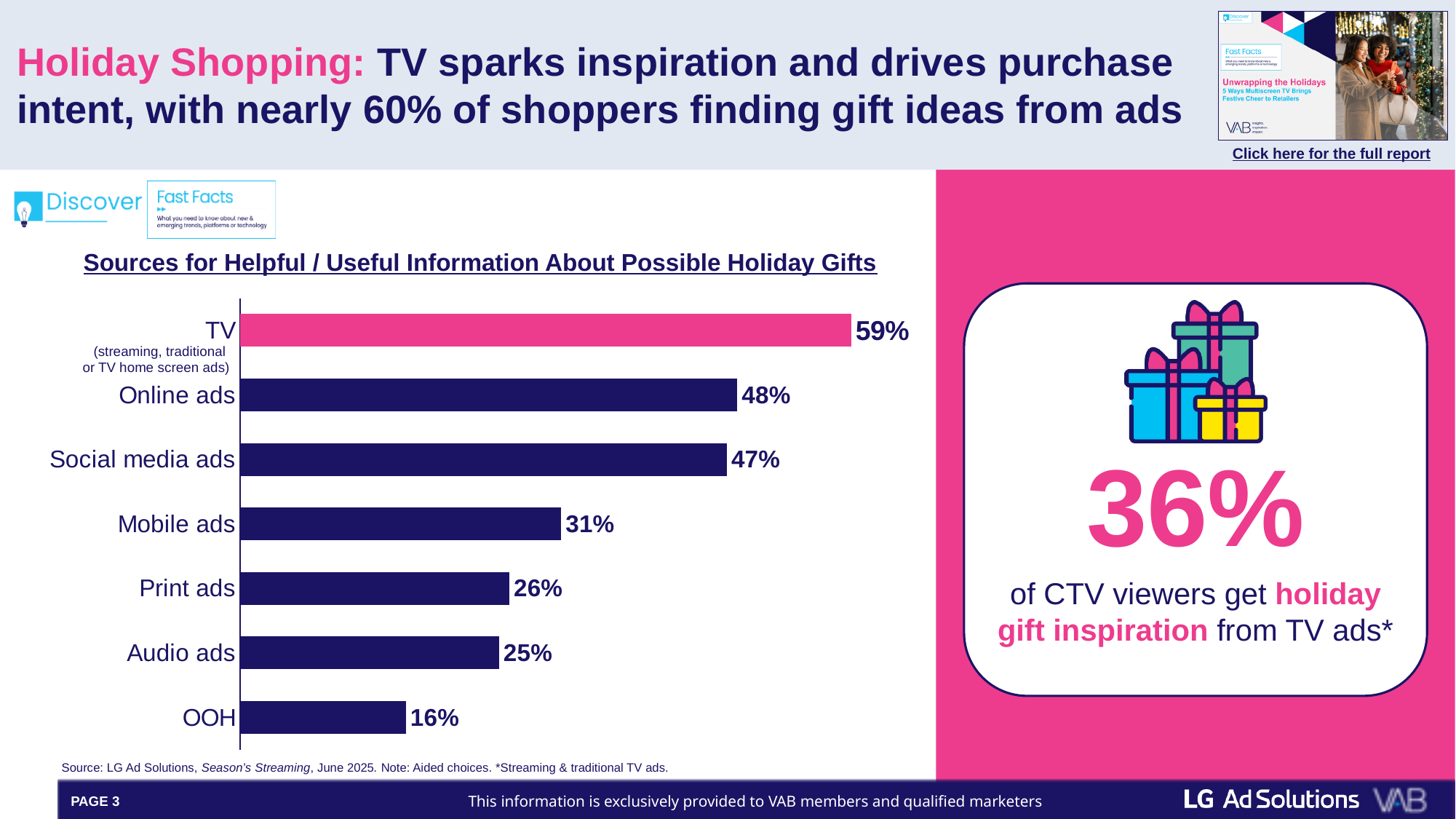
Which source has the lowest percentage in the chart? OOH What type of chart is used to show the sources for helpful information about holiday gifts? Bar chart What is the difference in percentage points between Mobile ads and Print ads? 5 What is the value shown for OOH? 16% How many sources (categories) are shown in the bar chart? 7 Which is larger, the value for Online ads or the value for Mobile ads? Online ads Which bar in the chart is coloured pink rather than dark navy? TV What is the difference in percentage points between TV and Online ads? 11 Which is larger, the value for Print ads or the value for Audio ads? Print ads Which source has the highest percentage in the chart? TV What is the value shown for Social media ads? 47% What percentage of shoppers cite TV as a source for helpful information about possible holiday gifts? 59%